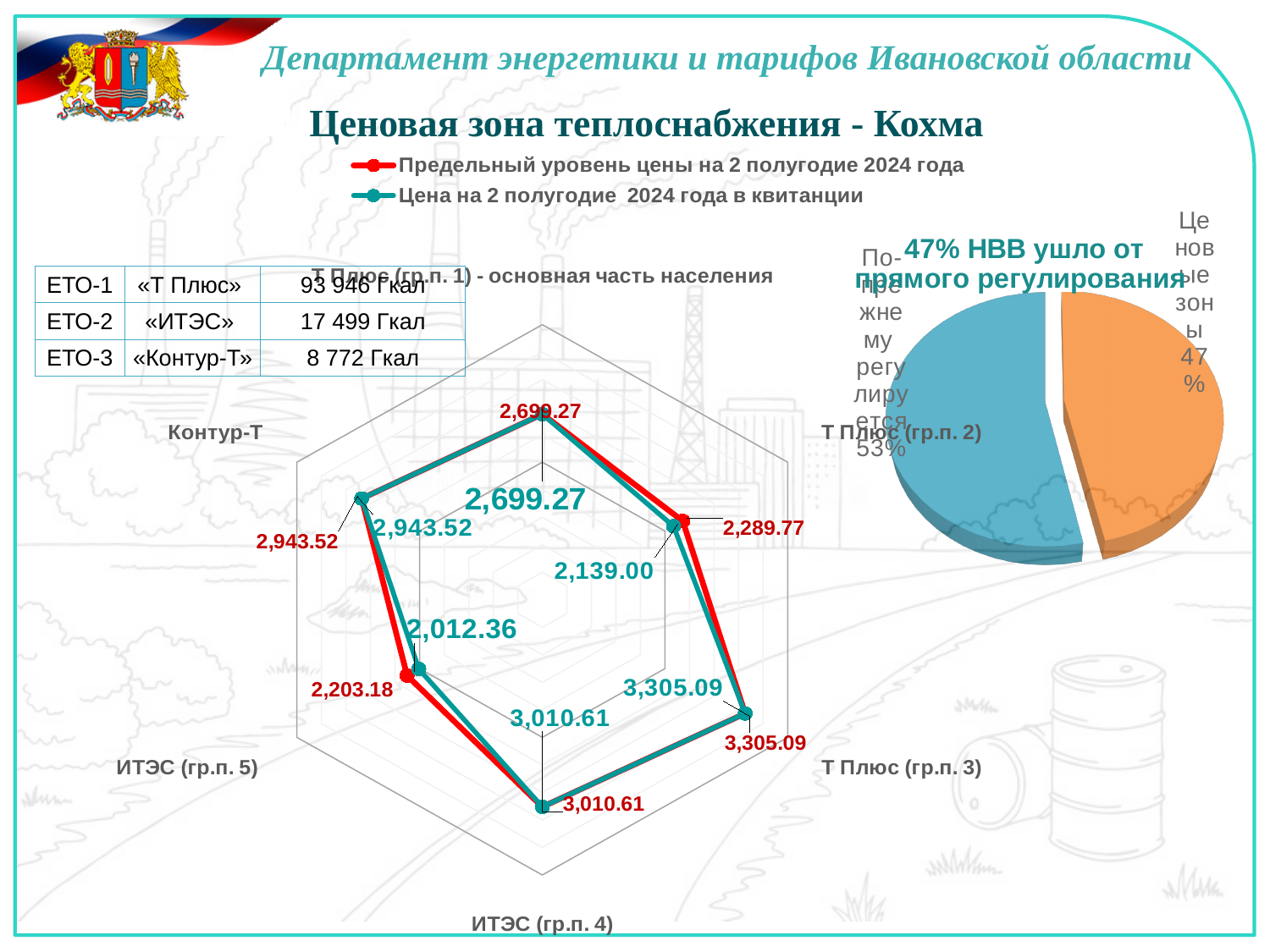
On the radar chart, which category has the highest value for 'Предельный уровень цены на 2 полугодие 2024 года'? Т Плюс (гр.п. 3) On the radar chart, what is the difference between 'Предельный уровень цены' and 'Цена в квитанции' for Т Плюс (гр.п. 2)? 150.77 On the radar chart, what is the value of 'Цена на 2 полугодие 2024 года в квитанции' for Т Плюс (гр.п. 2)? 2,139.00 On the pie chart titled '47% НВВ ушло от прямого регулирования', what share is 'По-прежнему регулируется'? 53% On the radar chart, which is larger for Т Плюс (гр.п. 2): 'Предельный уровень цены' or 'Цена в квитанции'? Предельный уровень цены On the radar chart, what is the value of 'Предельный уровень цены на 2 полугодие 2024 года' for Т Плюс (гр.п. 2)? 2,289.77 How many categories (axes) does the radar chart have? 6 On the radar chart, what is the value of 'Цена на 2 полугодие 2024 года в квитанции' for ИТЭС (гр.п. 5)? 2,012.36 On the radar chart, what is the difference between 'Предельный уровень цены' and 'Цена в квитанции' for ИТЭС (гр.п. 5)? 190.82 On the radar chart, what is the value of 'Предельный уровень цены на 2 полугодие 2024 года' for Контур-Т? 2,943.52 How many series does the legend of the radar chart list? 2 On the radar chart, which category has the lowest value for 'Цена на 2 полугодие 2024 года в квитанции'? ИТЭС (гр.п. 5)